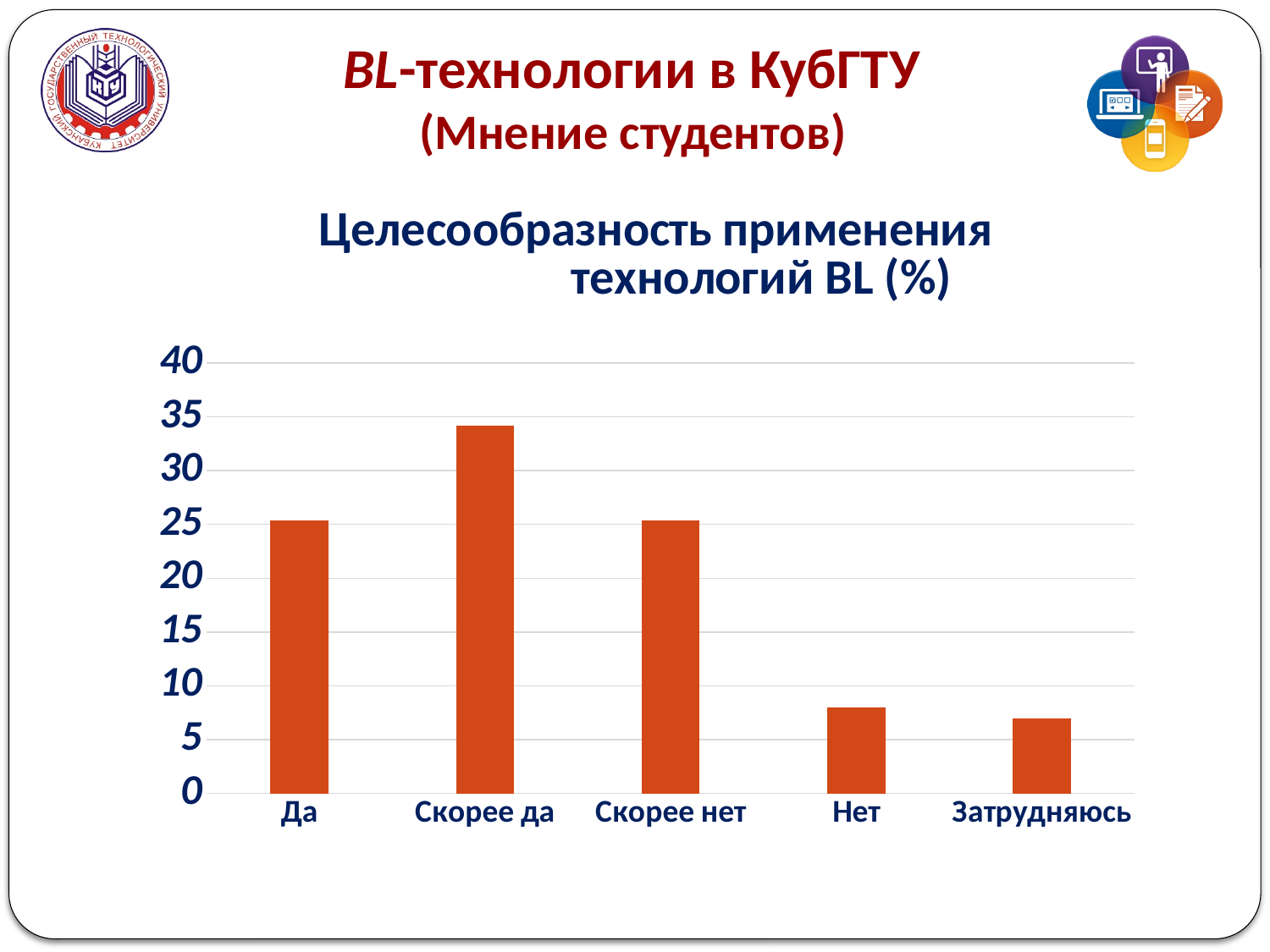
Is the value for Скорее нет greater or less than 20? greater Is the value for Да greater or less than 20? greater How many categories are shown on the x axis of the chart? 5 Is the value for Да greater or less than 30? less Which is larger, the value for Скорее да or the value for Да? Скорее да Which category has the highest bar in the chart? Скорее да What is the title of the chart? Целесообразность применения технологий BL (%) What kind of chart is shown on the slide? bar chart Which is larger, the value for Нет or the value for Скорее нет? Скорее нет